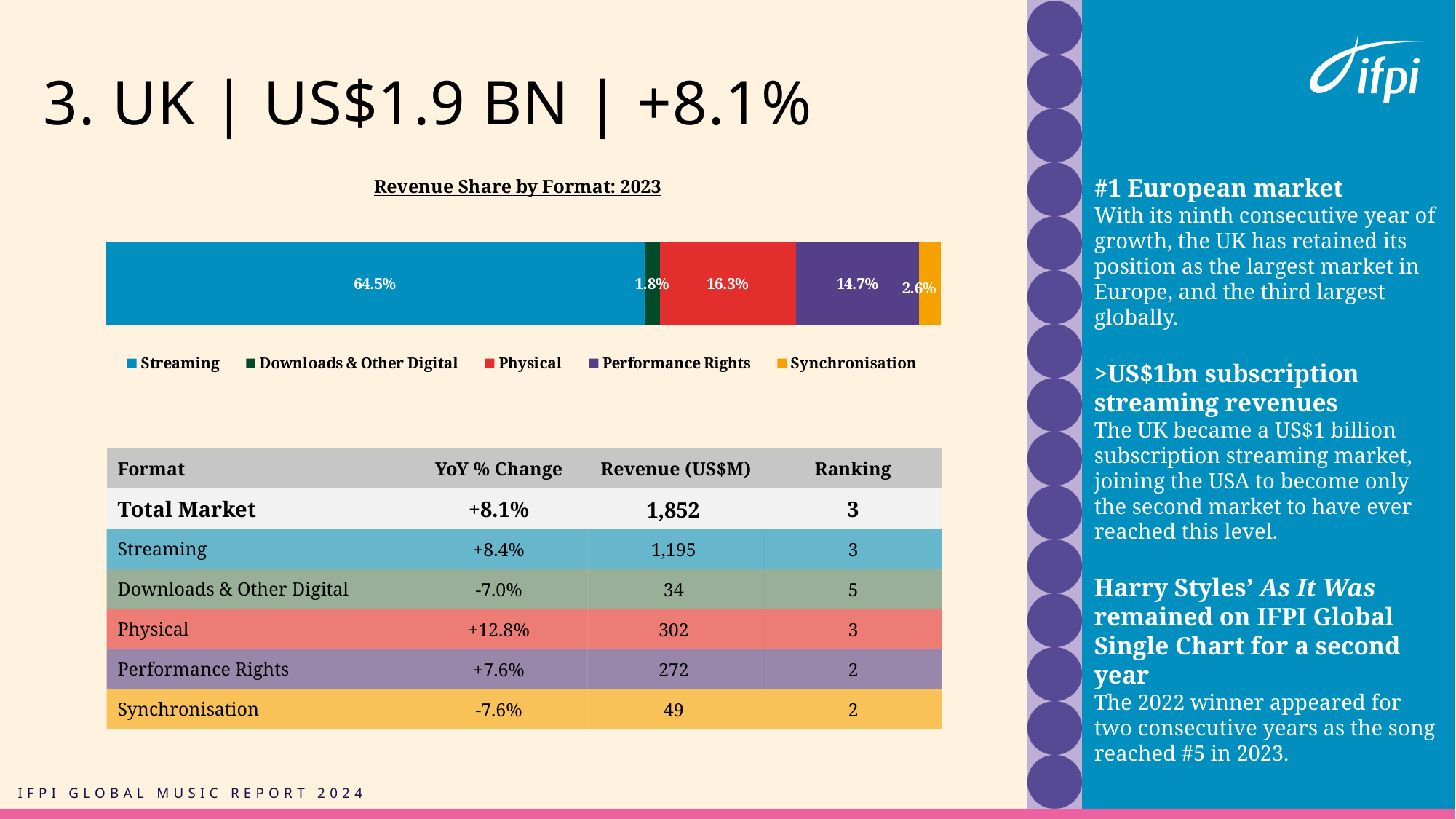
In the Revenue Share by Format: 2023 chart, what is the share for Streaming? 64.5% In the Revenue Share by Format: 2023 chart, which has the larger share, Physical or Performance Rights? Physical In the Revenue Share by Format: 2023 chart, what is the difference between the Physical share and the Performance Rights share? 1.6% In the Revenue Share by Format: 2023 chart, what is the share for Physical? 16.3% In the Revenue Share by Format: 2023 chart, what is the share for Downloads & Other Digital? 1.8% In the Revenue Share by Format: 2023 chart, what is the share for Synchronisation? 2.6% In the Revenue Share by Format: 2023 chart, what colour is the Synchronisation segment? Orange In the Revenue Share by Format: 2023 chart, which format has the largest share? Streaming What kind of chart is the Revenue Share by Format: 2023 chart? Stacked bar chart How many formats does the legend of the Revenue Share by Format: 2023 chart list? 5 In the Revenue Share by Format: 2023 chart, what is the share for Performance Rights? 14.7% In the Revenue Share by Format: 2023 chart, which format has the smallest share? Downloads & Other Digital